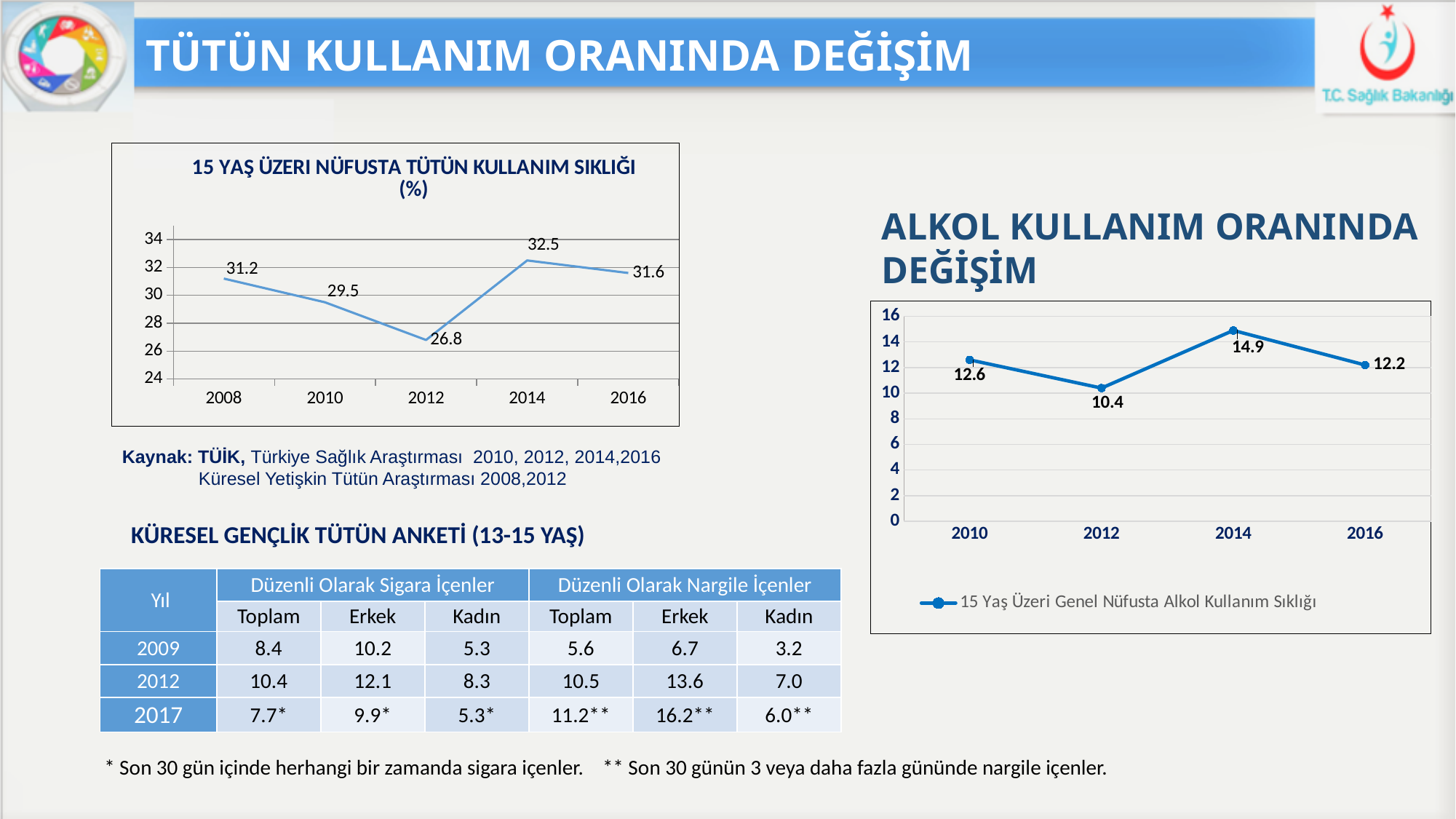
What type of chart is the one titled '15 YAŞ ÜZERI NÜFUSTA TÜTÜN KULLANIM SIKLIĞI (%)'? Line chart In the chart titled '15 YAŞ ÜZERI NÜFUSTA TÜTÜN KULLANIM SIKLIĞI (%)', how many years are plotted? 5 In the chart titled '15 YAŞ ÜZERI NÜFUSTA TÜTÜN KULLANIM SIKLIĞI (%)', what is the value for 2012? 26.8 In the chart under 'ALKOL KULLANIM ORANINDA DEĞİŞİM', what series name does the legend show? 15 Yaş Üzeri Genel Nüfusta Alkol Kullanım Sıklığı In the chart titled '15 YAŞ ÜZERI NÜFUSTA TÜTÜN KULLANIM SIKLIĞI (%)', which year has the lowest value? 2012 In the chart titled '15 YAŞ ÜZERI NÜFUSTA TÜTÜN KULLANIM SIKLIĞI (%)', what is the difference between the 2014 and 2012 values? 5.7 In the chart titled '15 YAŞ ÜZERI NÜFUSTA TÜTÜN KULLANIM SIKLIĞI (%)', which year has the highest value? 2014 In the chart under 'ALKOL KULLANIM ORANINDA DEĞİŞİM', which year has the lowest value? 2012 In the chart under 'ALKOL KULLANIM ORANINDA DEĞİŞİM', what is the difference between the 2014 and 2016 values? 2.7 In the chart under 'ALKOL KULLANIM ORANINDA DEĞİŞİM', which is larger, the value for 2010 or the value for 2016? 2010 In the chart titled '15 YAŞ ÜZERI NÜFUSTA TÜTÜN KULLANIM SIKLIĞI (%)', does the value rise or fall from 2008 to 2012? Fall In the chart under 'ALKOL KULLANIM ORANINDA DEĞİŞİM', what is the value for 2014? 14.9